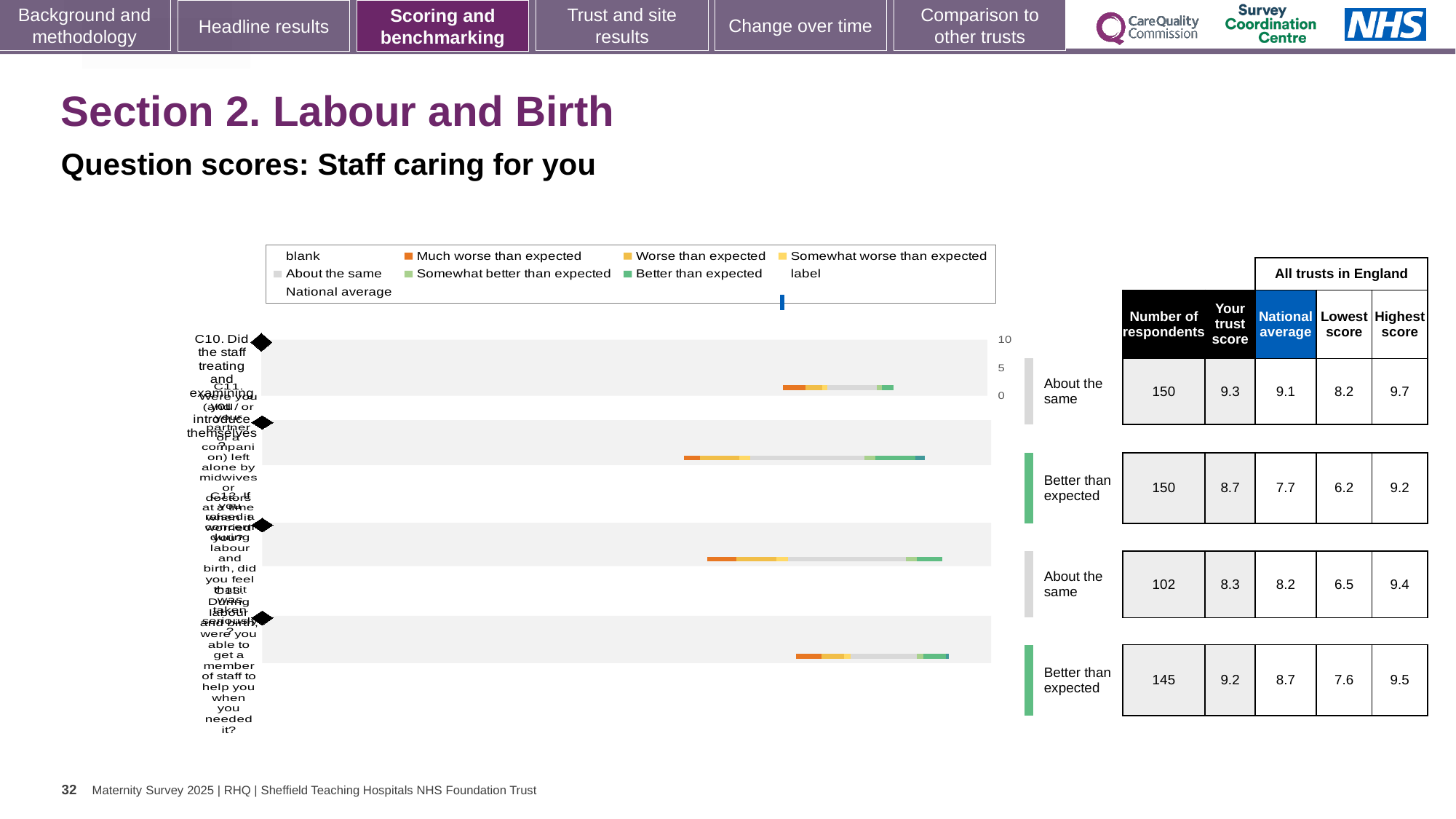
How many question rows (bars) are plotted in the chart? 4 In the table beside the chart, what is the 'Your trust score' for the top row? 9.3 In the table beside the chart, what is the highest score for the bottom row? 9.5 In the table beside the chart, what is the national average for the second row? 7.7 For the bottom row, is the trust score (9.2) or the national average (8.7) larger? trust score (9.2) In the table beside the chart, what is the number of respondents for the top row? 150 Which row has the highest 'Your trust score' in the table beside the chart? the top row (9.3) In the table beside the chart, what is the lowest score for the third row? 6.5 Which row has the lowest number of respondents in the table beside the chart? the third row (102) What is the difference between the trust score and the national average for the second row? 1.0 What benchmark label is shown for the second row of the chart? Better than expected What kind of chart is shown on the slide? bar chart